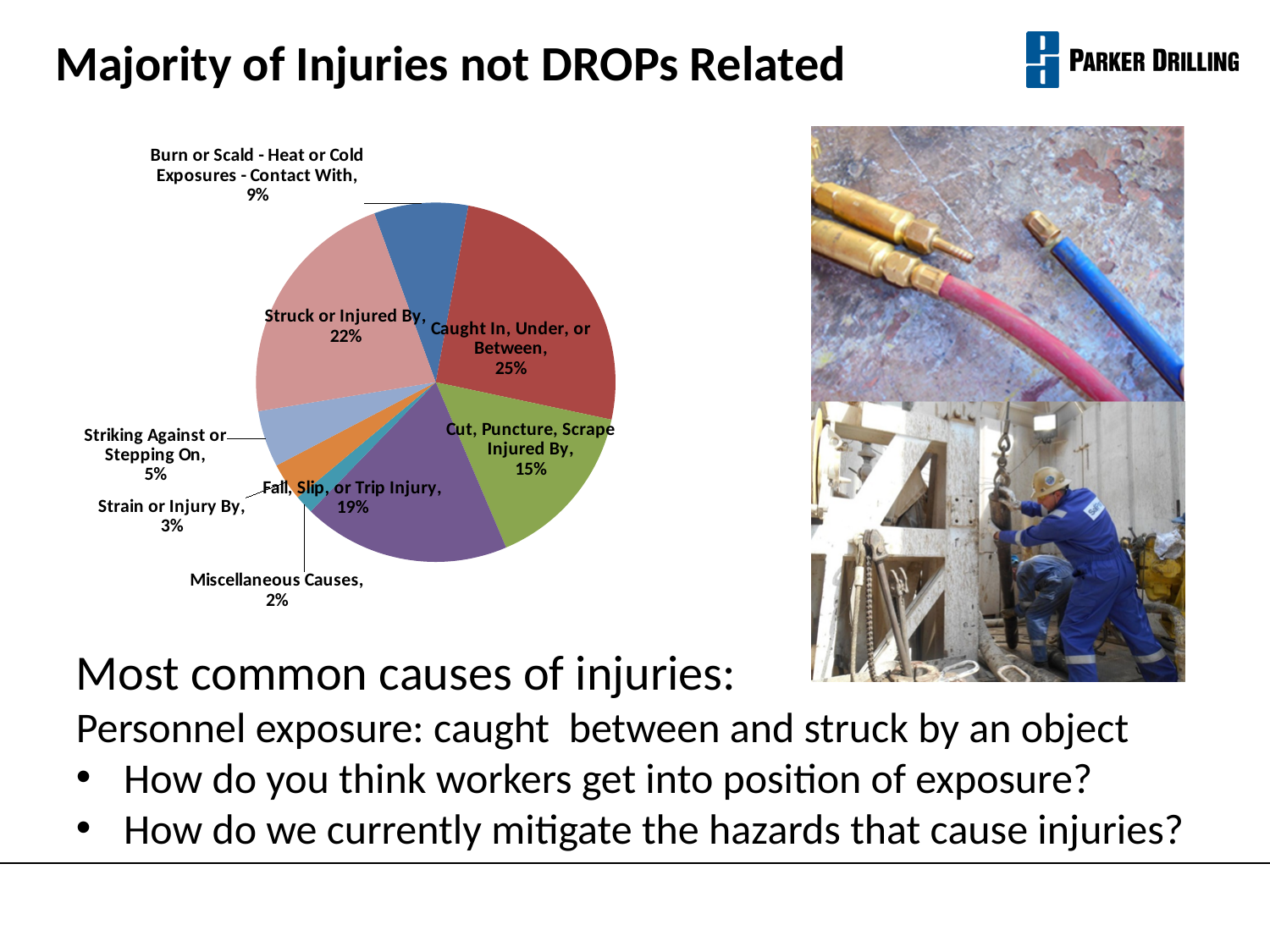
Which injury cause has the smallest slice of the pie? Miscellaneous Causes What share does the Burn or Scald - Heat or Cold Exposures - Contact With slice represent? 9% What is the difference in percentage points between Caught In, Under, or Between and Cut, Puncture, Scrape Injured By? 10% What share of injuries is attributed to Caught In, Under, or Between? 25% What is the title of the slide containing the pie chart? Majority of Injuries not DROPs Related What is the combined share of Caught In, Under, or Between and Struck or Injured By? 47% Which is larger: the share for Striking Against or Stepping On or the share for Strain or Injury By? Striking Against or Stepping On Which injury cause has the largest slice of the pie? Caught In, Under, or Between What kind of chart is shown on the slide? Pie chart What percentage of injuries is shown for Struck or Injured By? 22% What percentage is shown for Fall, Slip, or Trip Injury? 19% How many injury cause categories are shown in the pie chart? 8